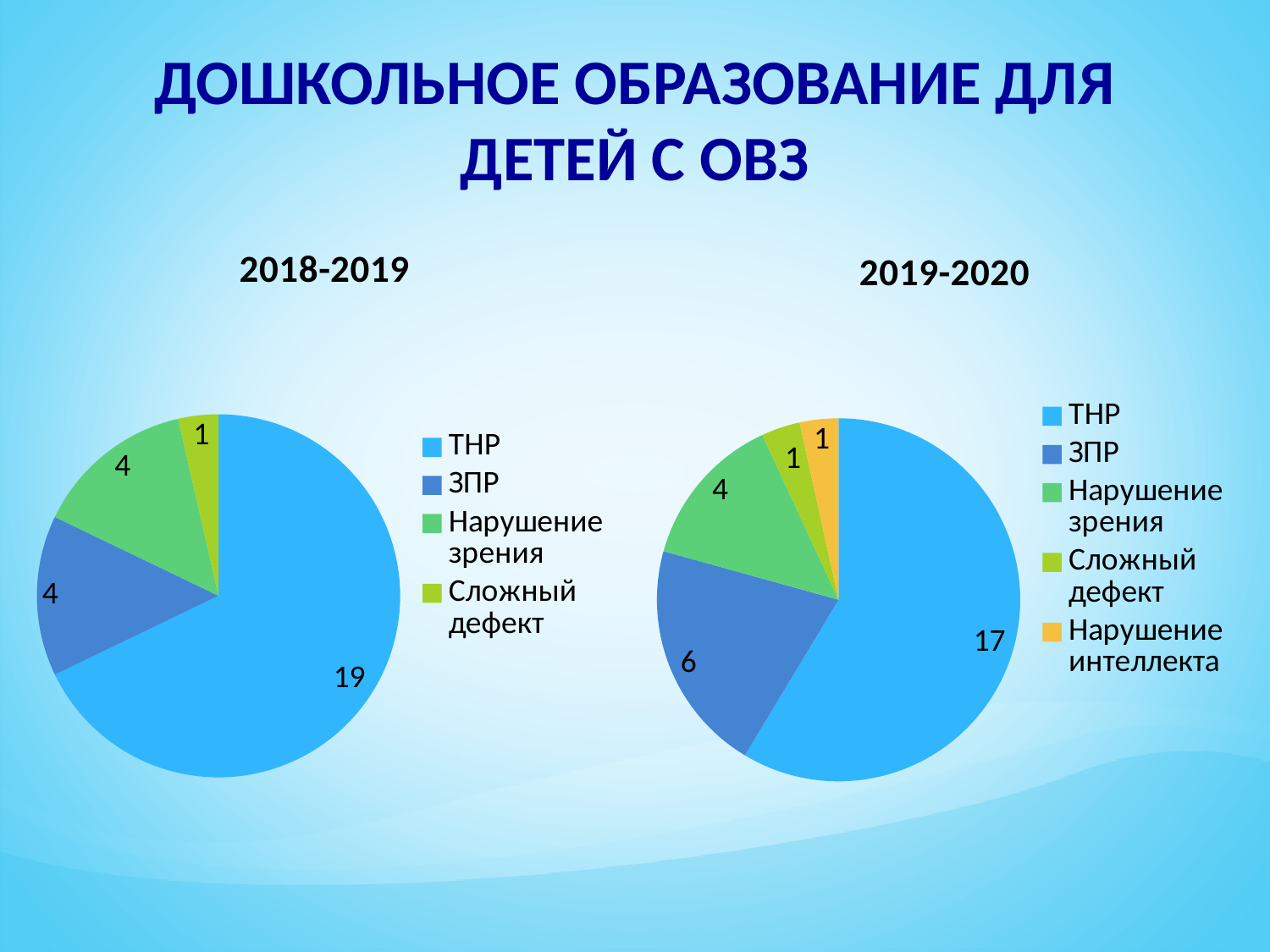
In the 2019-2020 pie chart, what is the value for Нарушение интеллекта? 1 In the 2018-2019 pie chart, which category has the smallest slice? Сложный дефект In the 2018-2019 pie chart, which category has the largest slice? ТНР In the 2018-2019 pie chart, what is the value for ТНР? 19 In the 2019-2020 pie chart, which is larger: ЗПР or Нарушение зрения? ЗПР What type of chart is used for the 2018-2019 data? Pie chart In the 2019-2020 pie chart, which category has the largest slice? ТНР What is the difference between the ТНР values in the 2018-2019 and 2019-2020 pie charts? 2 What is the total of all slices in the 2019-2020 pie chart? 29 How many categories does the legend of the 2019-2020 pie chart list? 5 In the 2019-2020 pie chart, what is the value for ЗПР? 6 How many categories does the legend of the 2018-2019 pie chart list? 4